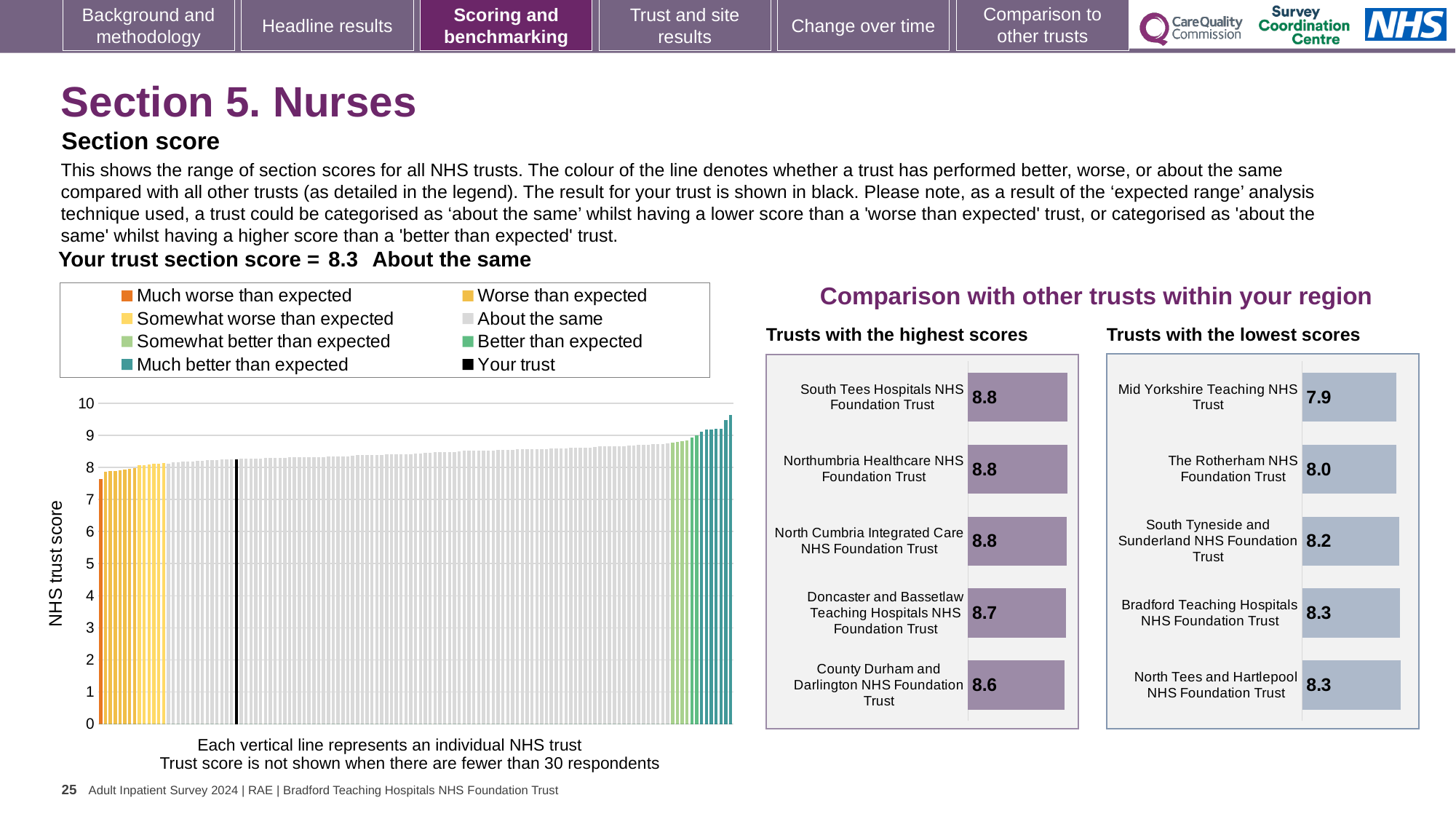
In the 'Trusts with the highest scores' chart, what is the score for County Durham and Darlington NHS Foundation Trust? 8.6 In the 'Trusts with the highest scores' chart, which trust has the lowest score? County Durham and Darlington NHS Foundation Trust In the 'Trusts with the highest scores' chart, which has the higher score: Doncaster and Bassetlaw Teaching Hospitals NHS Foundation Trust or County Durham and Darlington NHS Foundation Trust? Doncaster and Bassetlaw Teaching Hospitals NHS Foundation Trust What kind of chart is the large chart on the left showing NHS trust scores? Bar chart In the large chart on the left, do the trust scores rise or fall from left to right? Rise In the 'Trusts with the highest scores' chart, what is the difference between the score for South Tees Hospitals NHS Foundation Trust and the score for County Durham and Darlington NHS Foundation Trust? 0.2 In the 'Trusts with the lowest scores' chart, which trust has the lowest score? Mid Yorkshire Teaching NHS Trust In the 'Trusts with the lowest scores' chart, what is the score for Mid Yorkshire Teaching NHS Trust? 7.9 How many trusts are listed in the 'Trusts with the lowest scores' chart? 5 In the 'Trusts with the lowest scores' chart, what is the difference between the score for Bradford Teaching Hospitals NHS Foundation Trust and the score for Mid Yorkshire Teaching NHS Trust? 0.4 In the 'Trusts with the lowest scores' chart, what is the score for South Tyneside and Sunderland NHS Foundation Trust? 8.2 In the 'Trusts with the highest scores' chart, what is the score for Doncaster and Bassetlaw Teaching Hospitals NHS Foundation Trust? 8.7